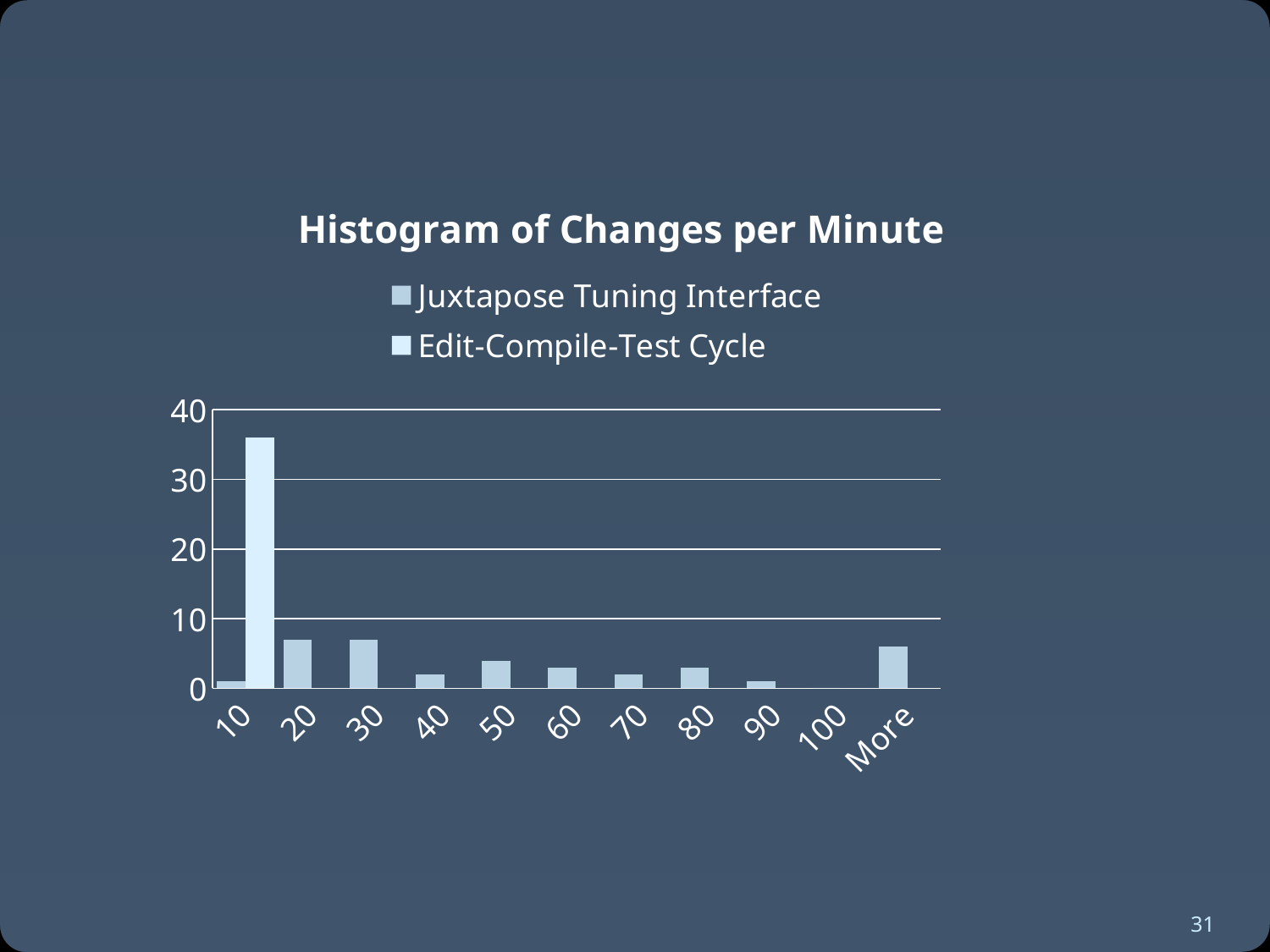
How many categories are shown on the x axis? 11 For the Juxtapose Tuning Interface series, which is larger: the value at More or the value at 90? More What is the title of the chart? Histogram of Changes per Minute At category 10, which series has the larger value: Juxtapose Tuning Interface or Edit-Compile-Test Cycle? Edit-Compile-Test Cycle Is the value for Juxtapose Tuning Interface at category More greater or less than 10? less Is the value for Juxtapose Tuning Interface at category 20 greater or less than 10? less For the Juxtapose Tuning Interface series, which is larger: the value at 20 or the value at 40? 20 Is the value for Edit-Compile-Test Cycle at category 10 greater or less than 30? greater How many series does the legend list? 2 Which two series are listed in the legend? Juxtapose Tuning Interface and Edit-Compile-Test Cycle Which category has the highest value for the Edit-Compile-Test Cycle series? 10 What kind of chart is shown on the slide? bar chart